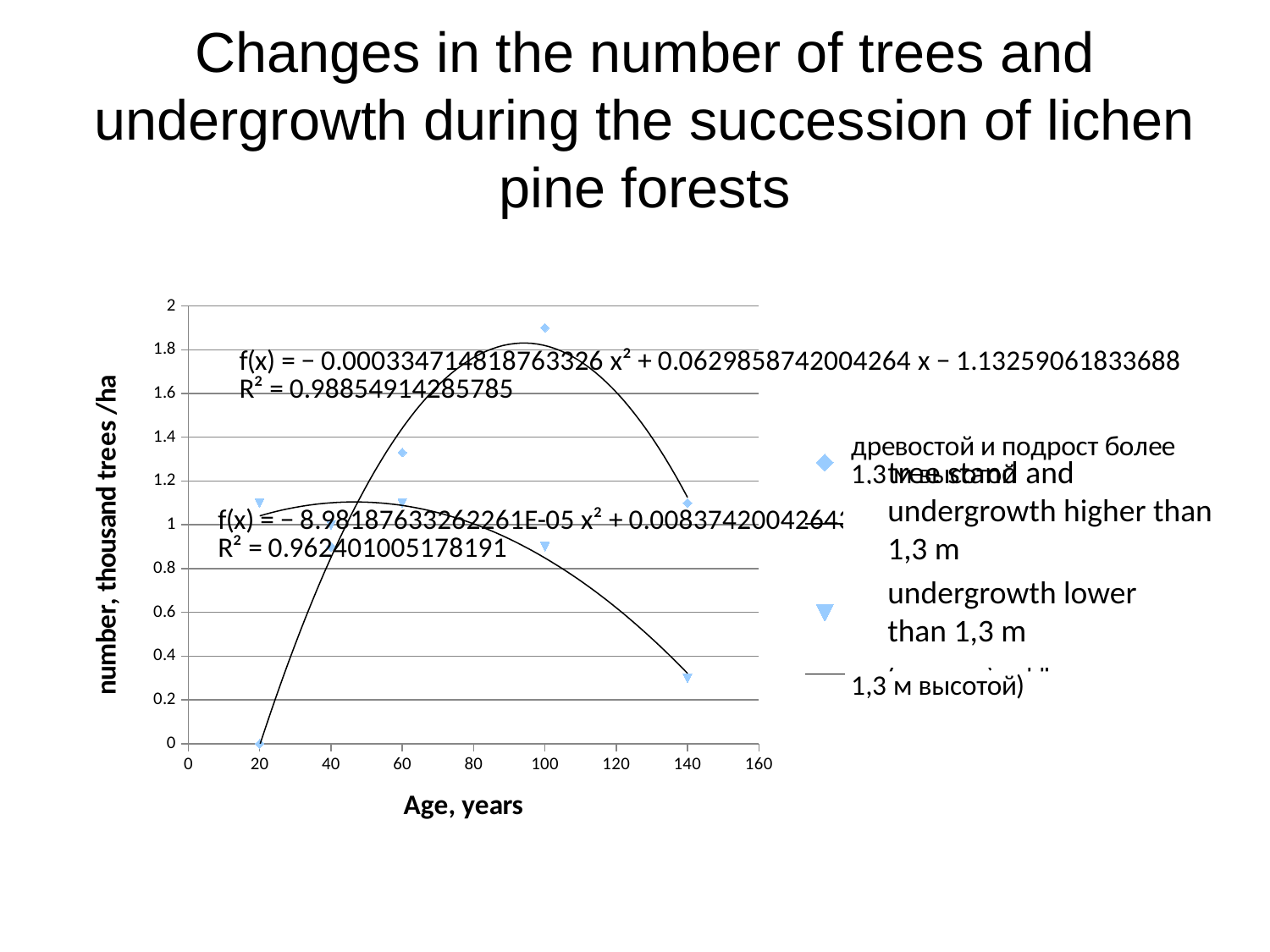
Is the value for 'tree stand and undergrowth higher than 1,3 m' at age 60 greater or less than 1.2? greater At which age is the value for 'tree stand and undergrowth higher than 1,3 m' lowest? 20 What kind of chart is shown on the slide? scatter chart What is the title of the x axis? Age, years How many data points are plotted for the 'undergrowth lower than 1,3 m' series? 5 At which age is the value for 'tree stand and undergrowth higher than 1,3 m' highest? 100 At age 140, which series has the larger value: 'tree stand and undergrowth higher than 1,3 m' or 'undergrowth lower than 1,3 m'? tree stand and undergrowth higher than 1,3 m What is the title of the y axis? number, thousand trees /ha Is the value for 'undergrowth lower than 1,3 m' at age 100 greater or less than 1? less Is the value for 'undergrowth lower than 1,3 m' at age 140 greater or less than 0.4? less At which age is the value for 'undergrowth lower than 1,3 m' lowest? 140